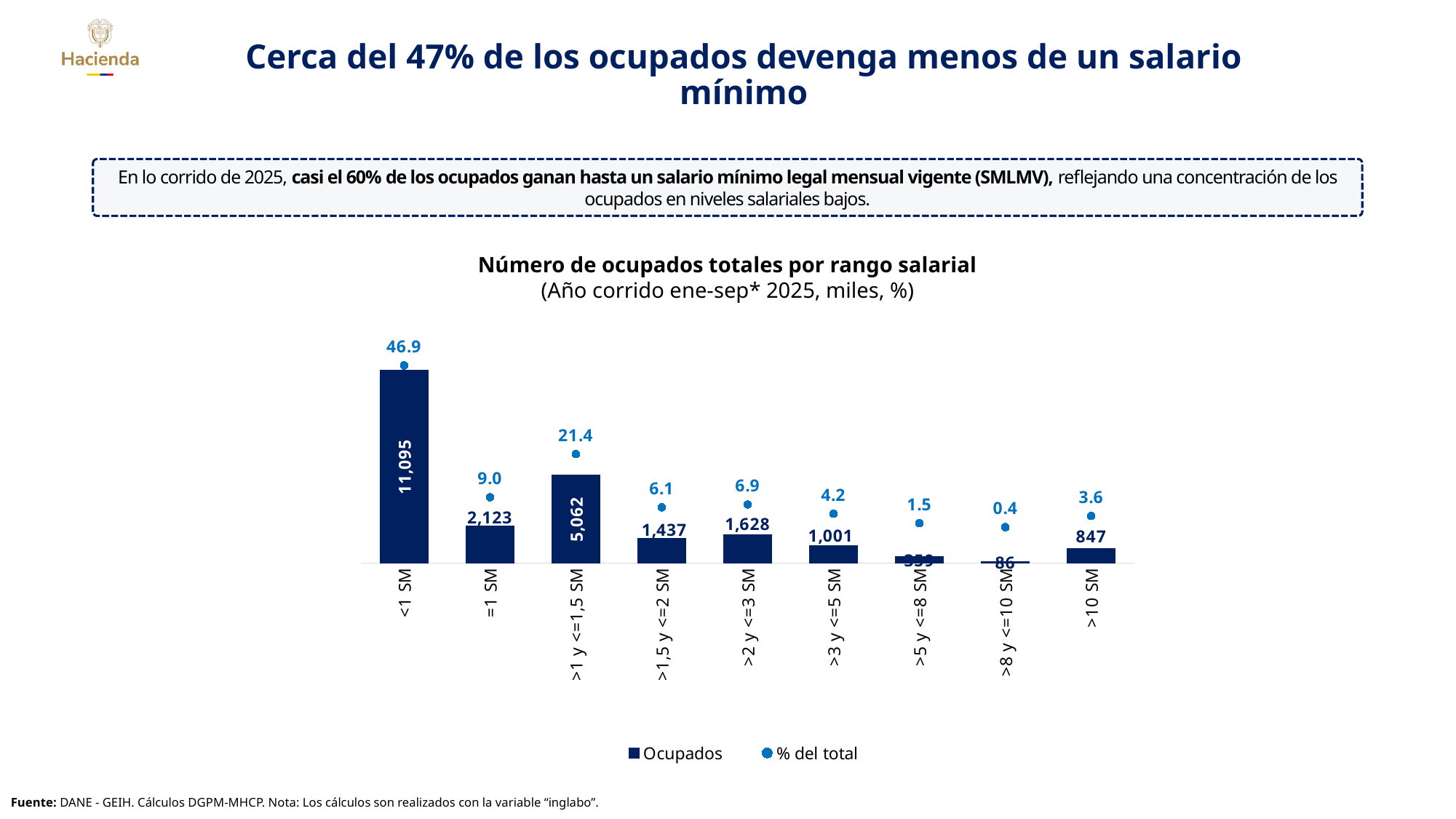
What is the number of Ocupados for the >2 y <=3 SM category? 1,628 What is the number of Ocupados for the <1 SM category? 11,095 What kind of chart is used to show the Ocupados series? Bar chart Which has more Ocupados: =1 SM or >1,5 y <=2 SM? =1 SM How many salary range categories are shown on the x axis? 9 What is the title of the chart? Número de ocupados totales por rango salarial Which salary range has the lowest number of Ocupados? >8 y <=10 SM What is the % del total for the >1 y <=1,5 SM category? 21.4 What is the % del total for the >8 y <=10 SM category? 0.4 What is the difference in Ocupados between the <1 SM and >1 y <=1,5 SM categories? 6,033 Which salary range has the highest number of Ocupados? <1 SM How many series does the legend list? 2